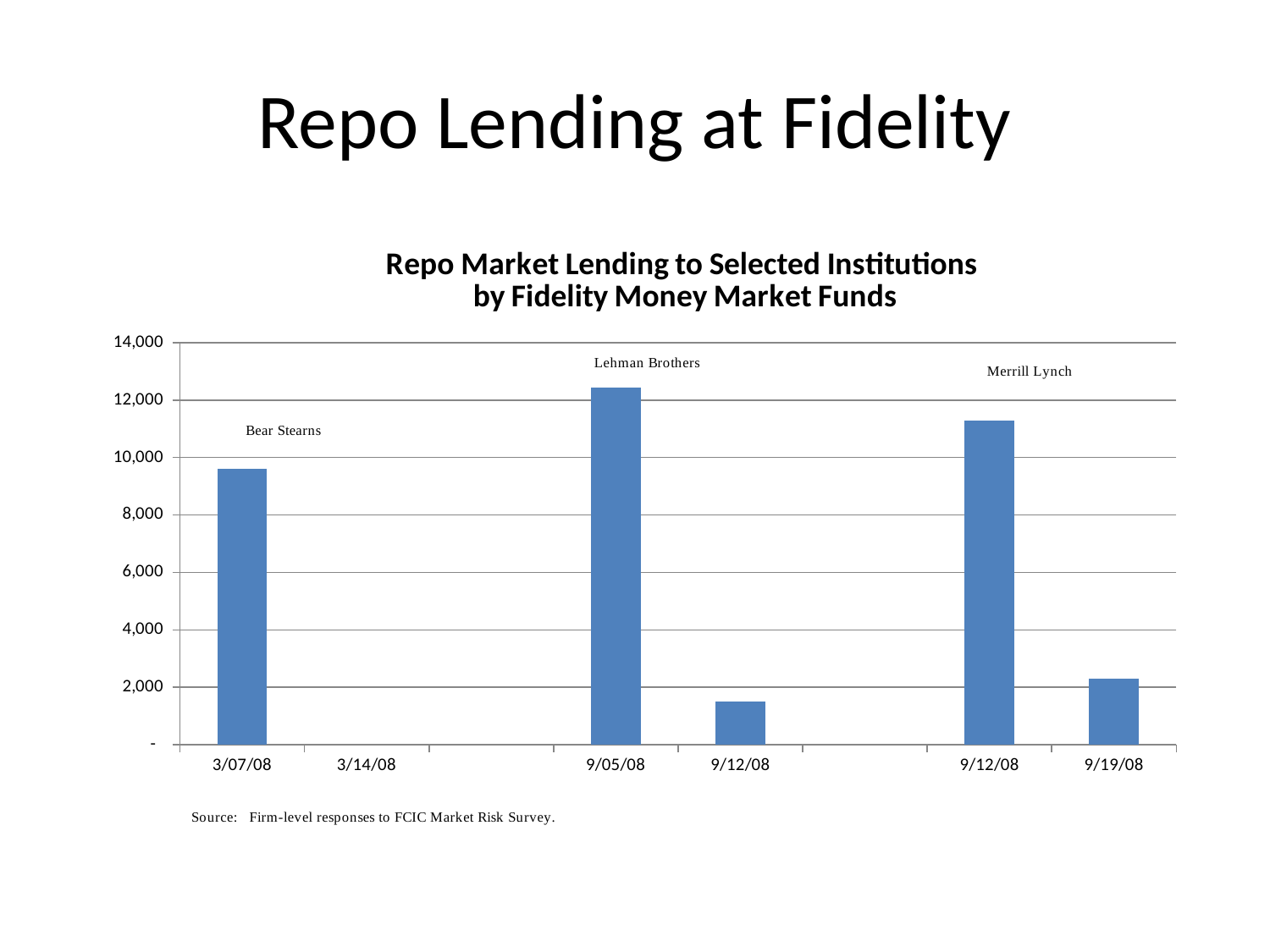
What is the title of the chart? Repo Market Lending to Selected Institutions by Fidelity Money Market Funds Is the value for Lehman Brothers on 9/05/08 greater or less than 12,000? greater Is the value for Bear Stearns on 3/07/08 greater or less than 8,000? greater Which institution's bars are labelled above the first pair of dates on the chart? Bear Stearns What kind of chart is shown on the slide? bar chart Is the value for Lehman Brothers on 9/12/08 greater or less than 2,000? less Which date has the tallest bar in the chart? 9/05/08 Does repo lending to Lehman Brothers rise or fall from 9/05/08 to 9/12/08? fall How many dates are labelled along the x axis of the chart? 6 Which is larger: the bar for Lehman Brothers on 9/05/08 or the bar for Merrill Lynch on 9/12/08? Lehman Brothers on 9/05/08